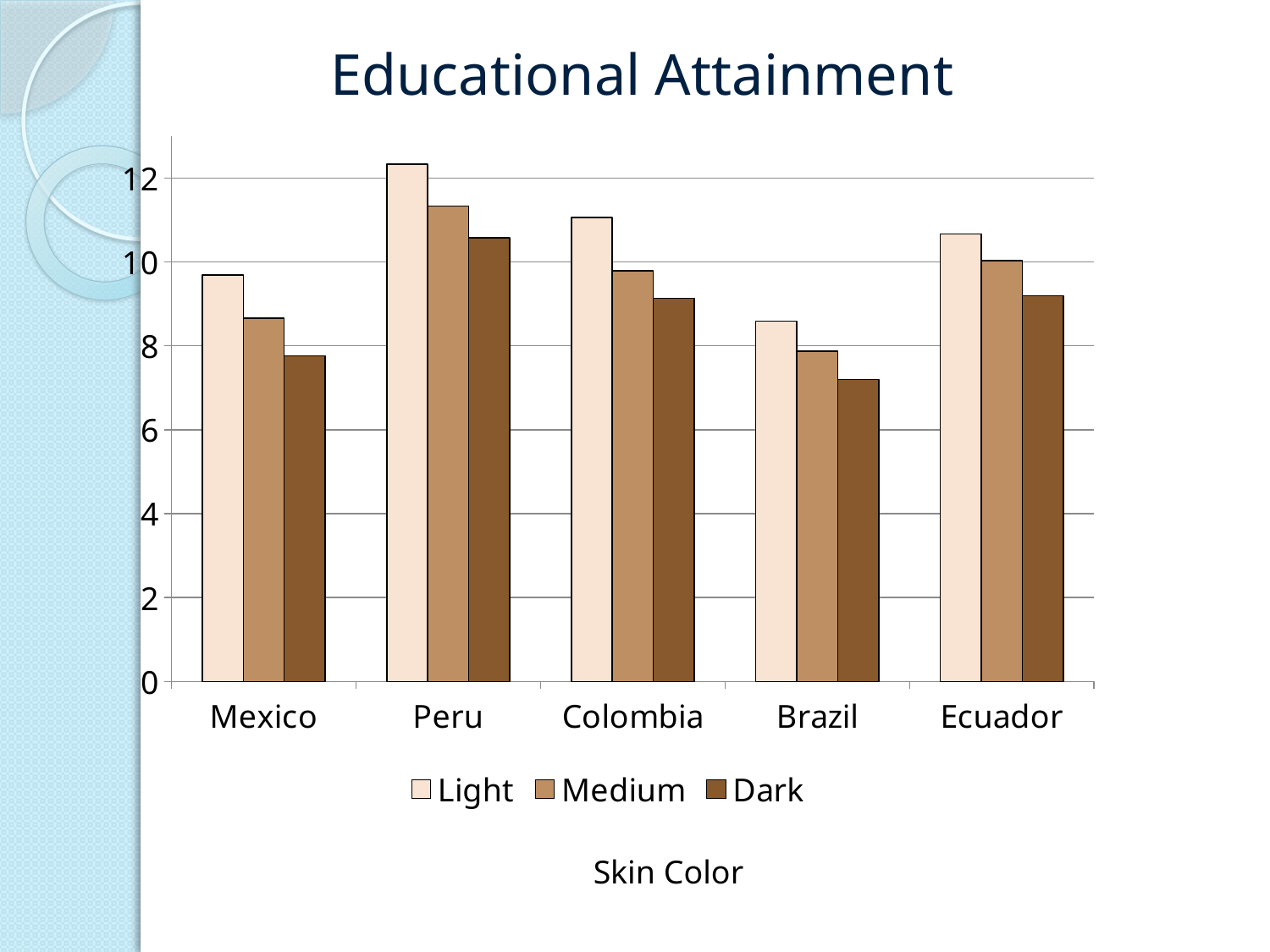
What is the title of the chart? Educational Attainment Is the Dark value for Peru greater or less than 10? greater Which country has the highest value for the Light series? Peru Is the Light value for Peru greater or less than 12? greater Which is larger, the Light value for Colombia or the Light value for Brazil? Colombia What is the label shown below the legend on the x axis? Skin Color How many series does the legend list? 3 Is the Dark value for Brazil greater or less than 8? less How many countries are shown on the x axis? 5 What kind of chart is shown on the slide? bar chart Which country has the lowest value for the Dark series? Brazil